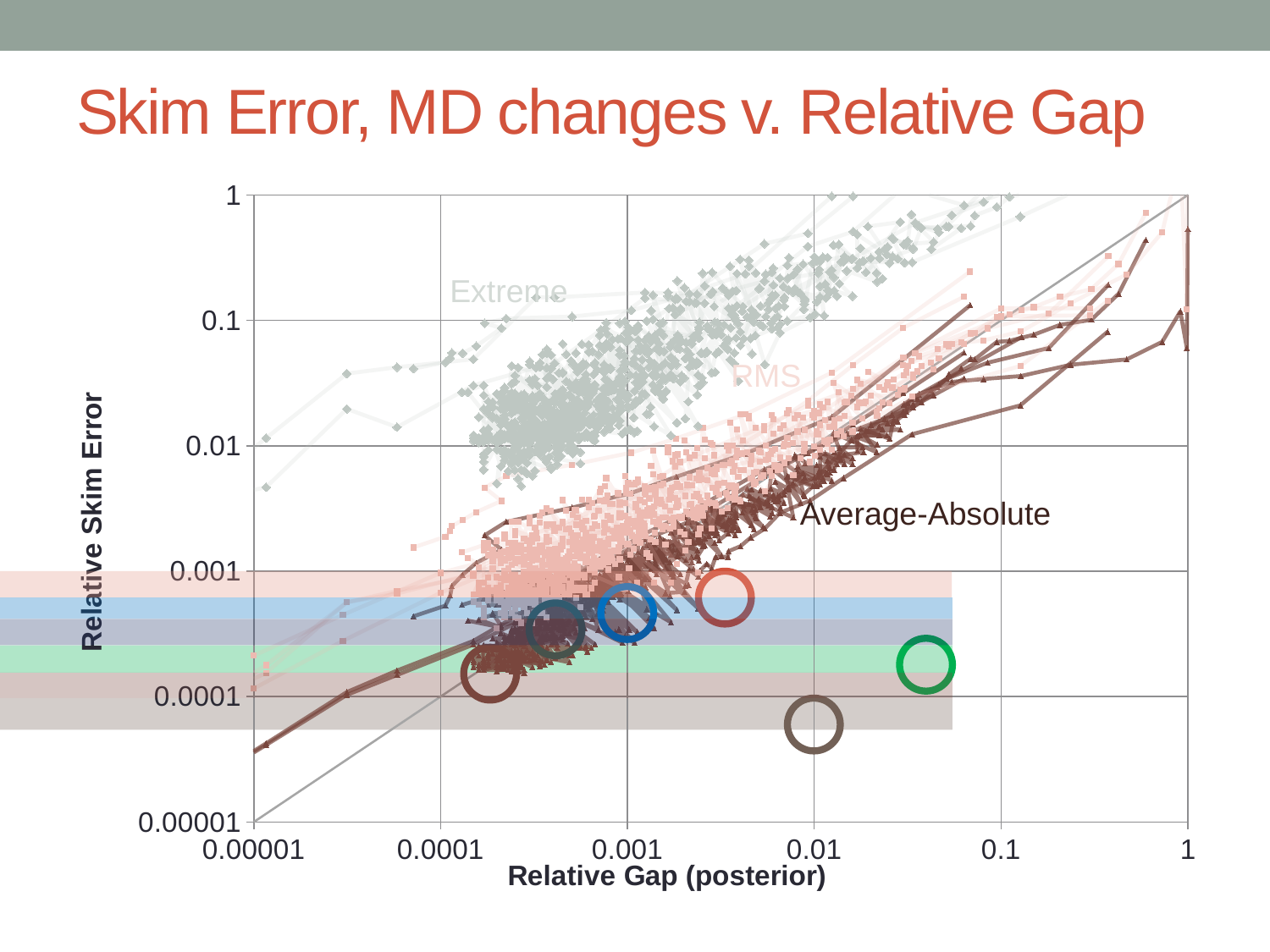
Which labeled series has the highest Relative Skim Error values overall? Extreme What is the highest tick value shown on the x axis? 1 Which labeled series has the lowest Relative Skim Error values overall? Average-Absolute Which series lies higher on the chart, RMS or Average-Absolute? RMS Which series lies higher on the chart, Extreme or RMS? Extreme What kind of chart is shown on the slide? Scatter chart What is the title of the chart? Skim Error, MD changes v. Relative Gap What is the lowest tick value shown on the y axis? 0.00001 How many named data series are labeled on the chart? 3 Do the Relative Skim Error values rise or fall as Relative Gap increases along the x axis? Rise What is the label of the x axis? Relative Gap (posterior)